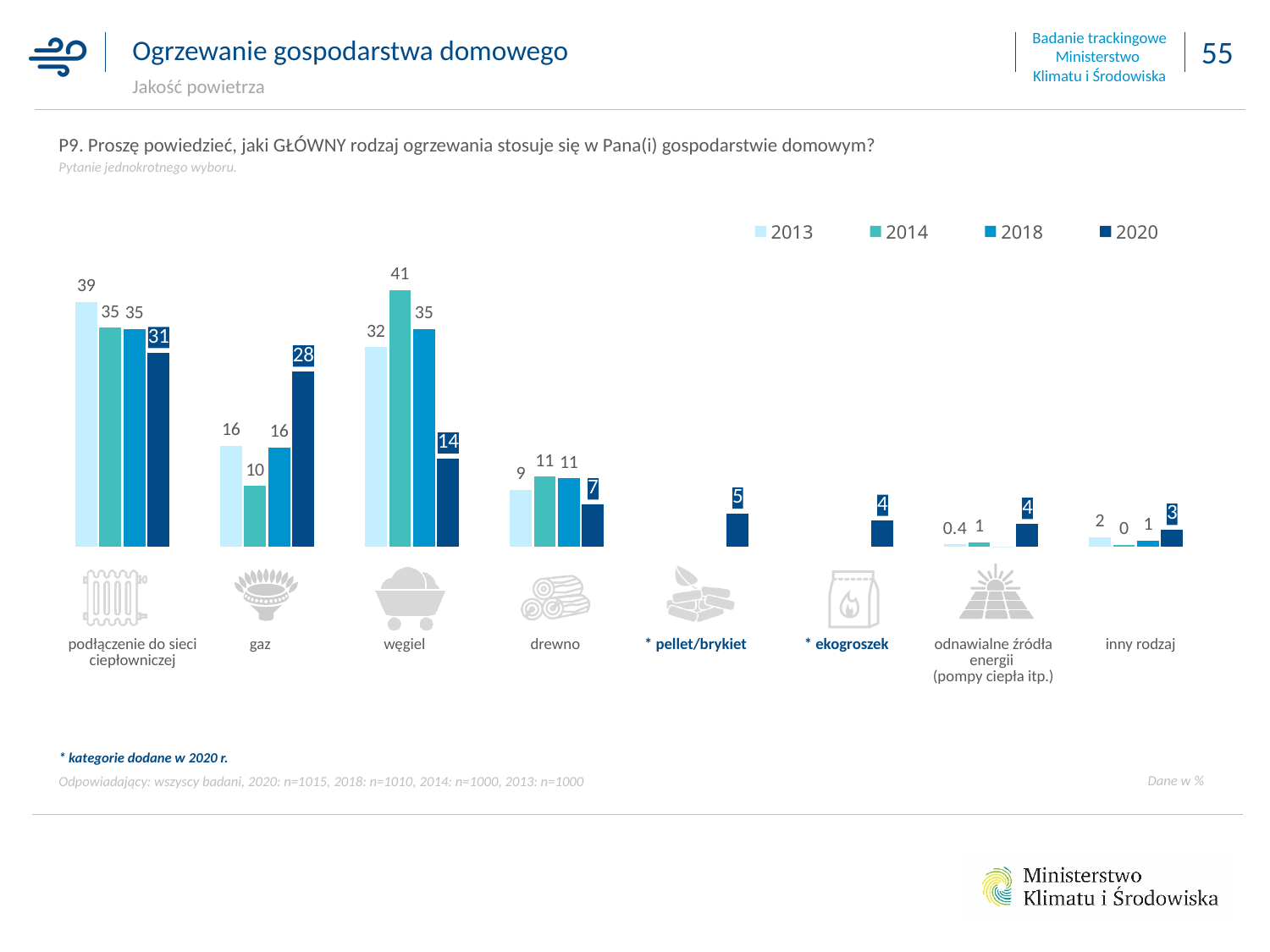
How many categories are shown on the x axis? 8 What is the value for pellet/brykiet in 2020? 5 What is the value for węgiel in 2014? 41 What is the value for drewno in 2020? 7 What is the value for podłączenie do sieci ciepłowniczej in 2013? 39 What is the difference between the 2014 and 2020 values for węgiel? 27 Which is larger for gaz: the 2013 value or the 2020 value? 2020 What kind of chart is shown on the slide? bar chart Which category has the highest value in the 2014 series? węgiel How many series does the legend list? 4 What is the value for gaz in 2020? 28 Which category has the highest value in the 2020 series? podłączenie do sieci ciepłowniczej